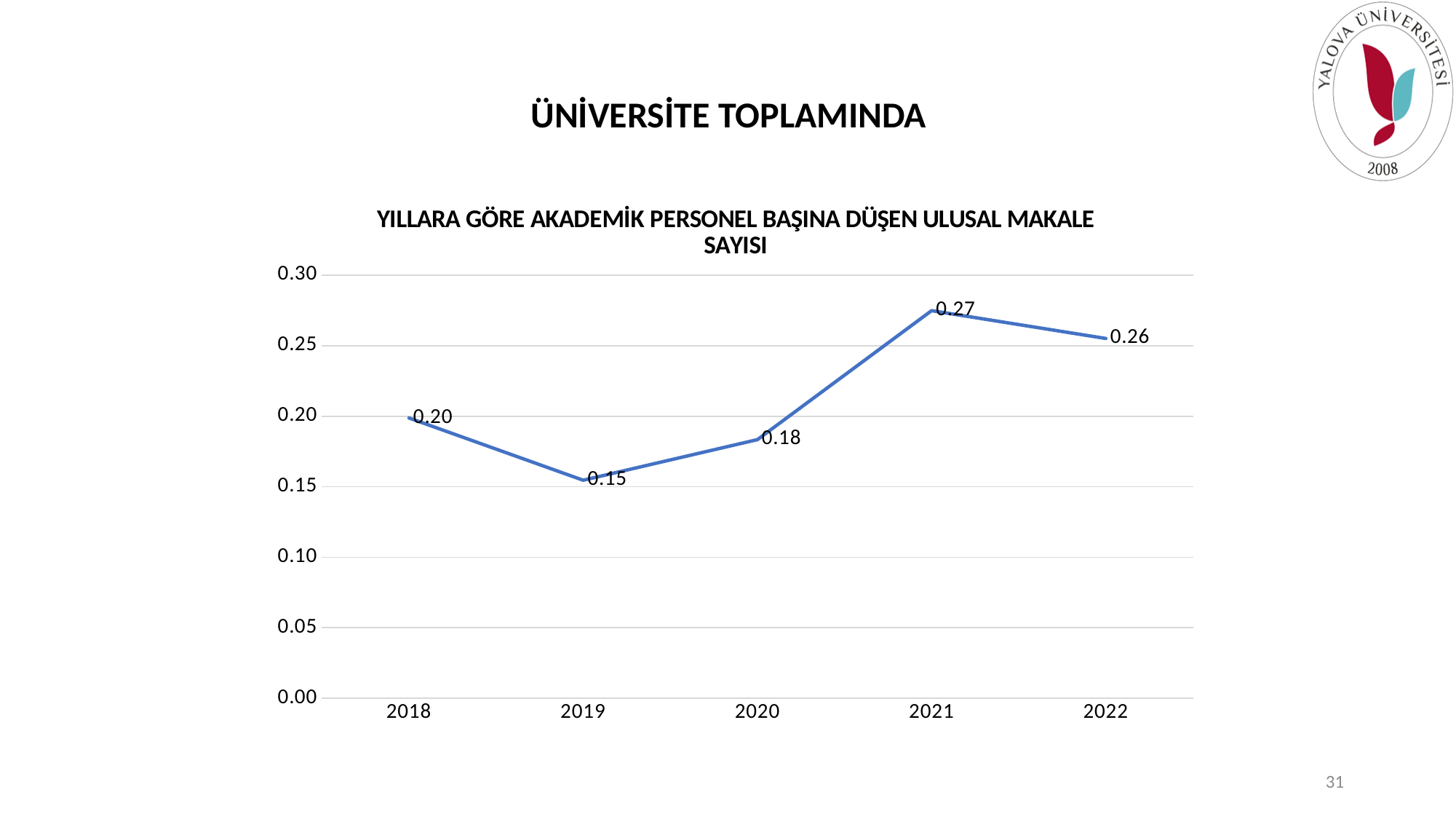
What is the value for 2018? 0.20 What is the difference between the values for 2021 and 2019? 0.12 Is the value for 2021 greater or less than 0.25? greater What is the value for 2021? 0.27 What kind of chart is shown on the slide? line chart Which is larger, the value for 2020 or the value for 2018? 2018 What is the value for 2019? 0.15 What is the value for 2022? 0.26 Which year has the lowest value? 2019 How many years are shown on the x axis? 5 Does the value rise or fall from 2021 to 2022? fall Which year has the highest value? 2021